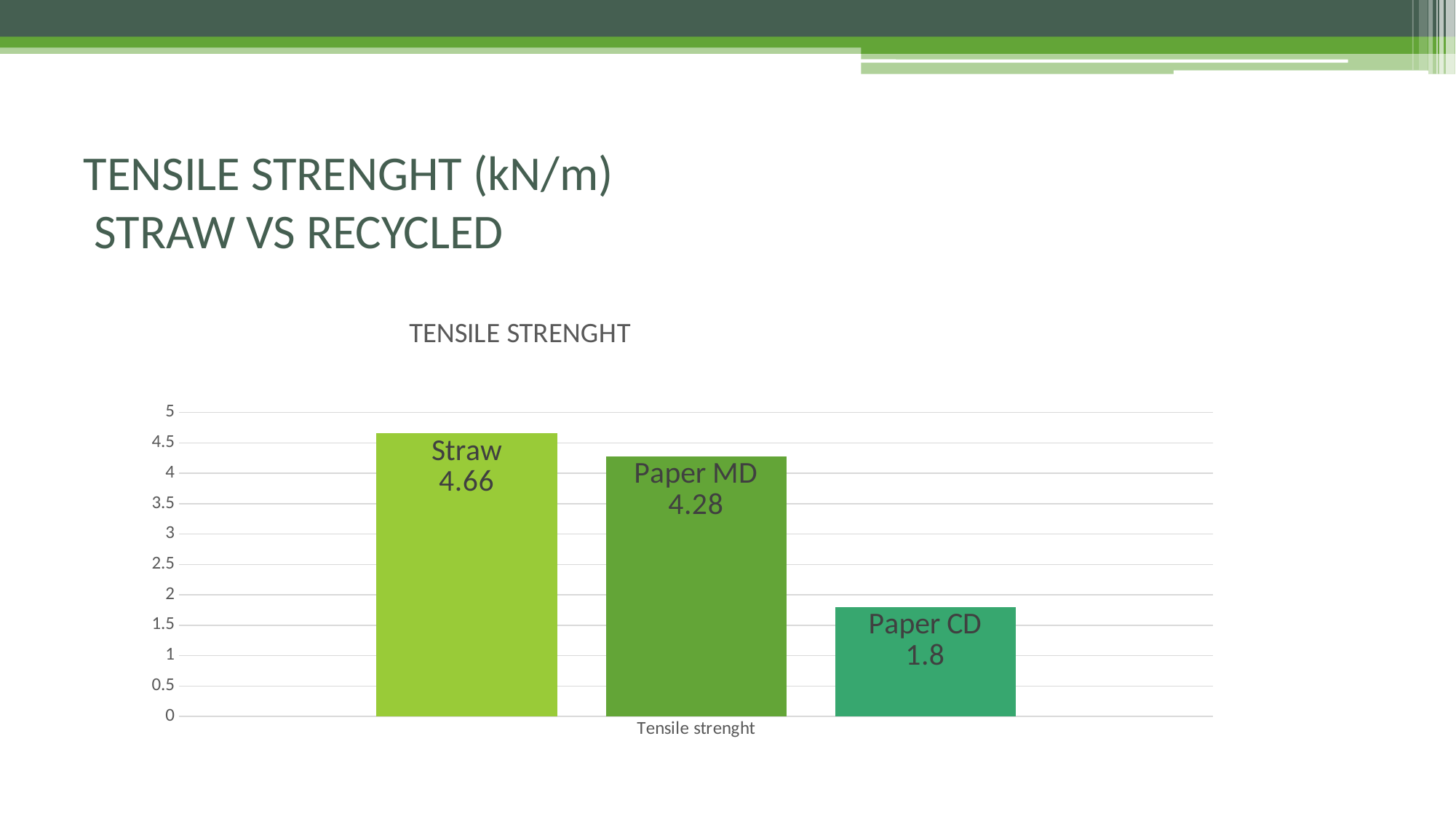
What kind of chart is shown on the slide? bar chart What is the tensile strength value for Straw? 4.66 How many bars are shown in the chart? 3 What is the difference between the tensile strength of Straw and Paper MD? 0.38 What is the difference between the tensile strength of Paper MD and Paper CD? 2.48 Which has a larger tensile strength, Paper MD or Paper CD? Paper MD Which material has the highest tensile strength? Straw What is the title of the chart? TENSILE STRENGHT Which material has the lowest tensile strength? Paper CD What is the tensile strength value for Paper MD? 4.28 What is the tensile strength value for Paper CD? 1.8 Is the value for Paper CD greater or less than 2? less